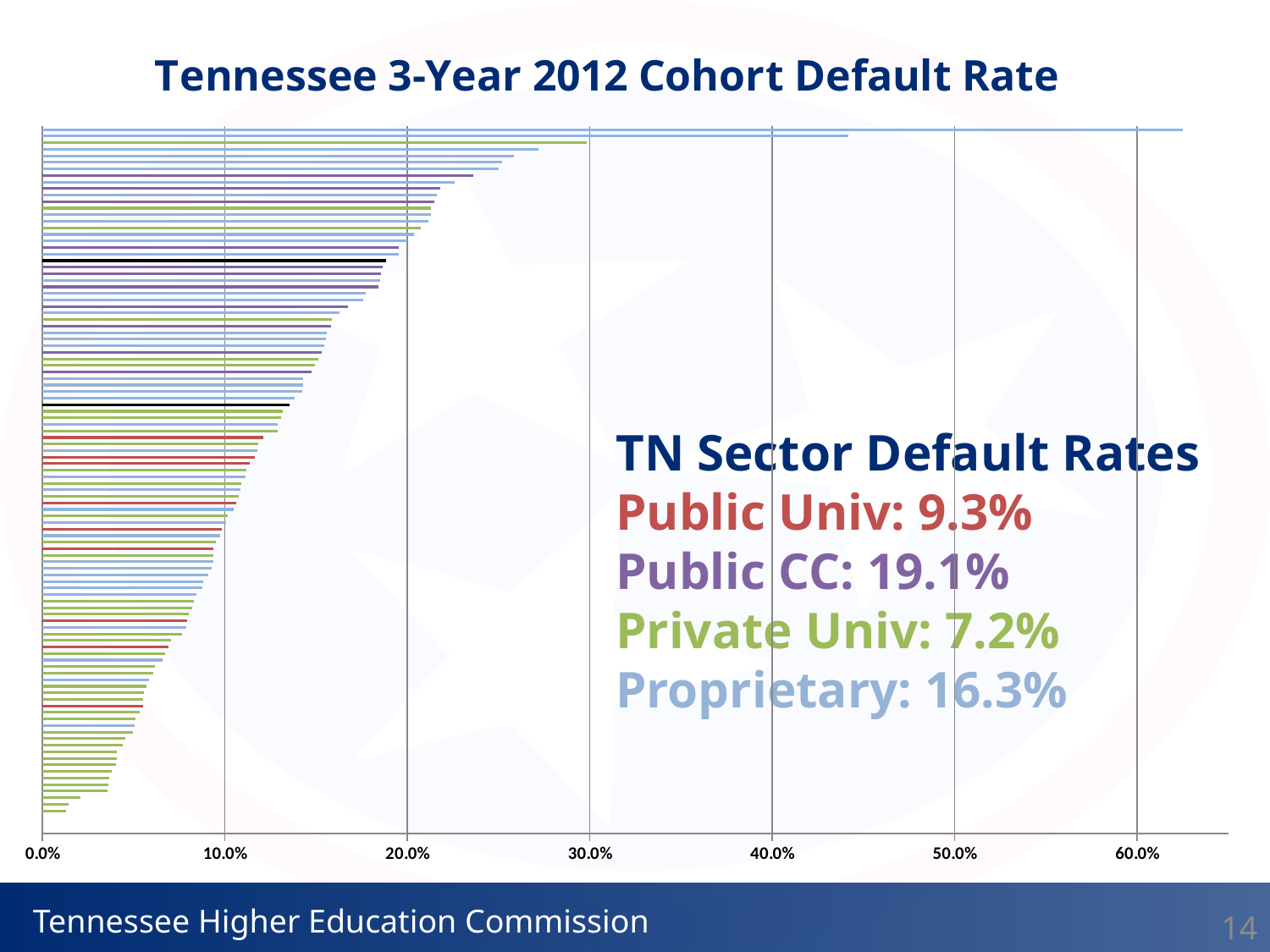
What kind of chart is shown on the slide? bar chart Which sector listed in the TN Sector Default Rates text has the lowest default rate? Private Univ According to the TN Sector Default Rates text on the slide, what is the default rate for Public CC? 19.1% According to the TN Sector Default Rates text on the slide, what is the default rate for Public Univ? 9.3% According to the TN Sector Default Rates text on the slide, what is the default rate for Proprietary institutions? 16.3% What is the highest value labelled on the horizontal axis of the chart? 60.0% Which has a higher default rate in the TN Sector Default Rates text, Public CC or Proprietary? Public CC What is the difference between the Public CC default rate and the Public Univ default rate shown on the slide? 9.8 percentage points How many sectors are listed in the TN Sector Default Rates text on the slide? 4 What is the title of the chart on the slide? Tennessee 3-Year 2012 Cohort Default Rate Which sector listed in the TN Sector Default Rates text has the highest default rate? Public CC Is the value of the longest bar in the chart greater or less than 60.0%? greater